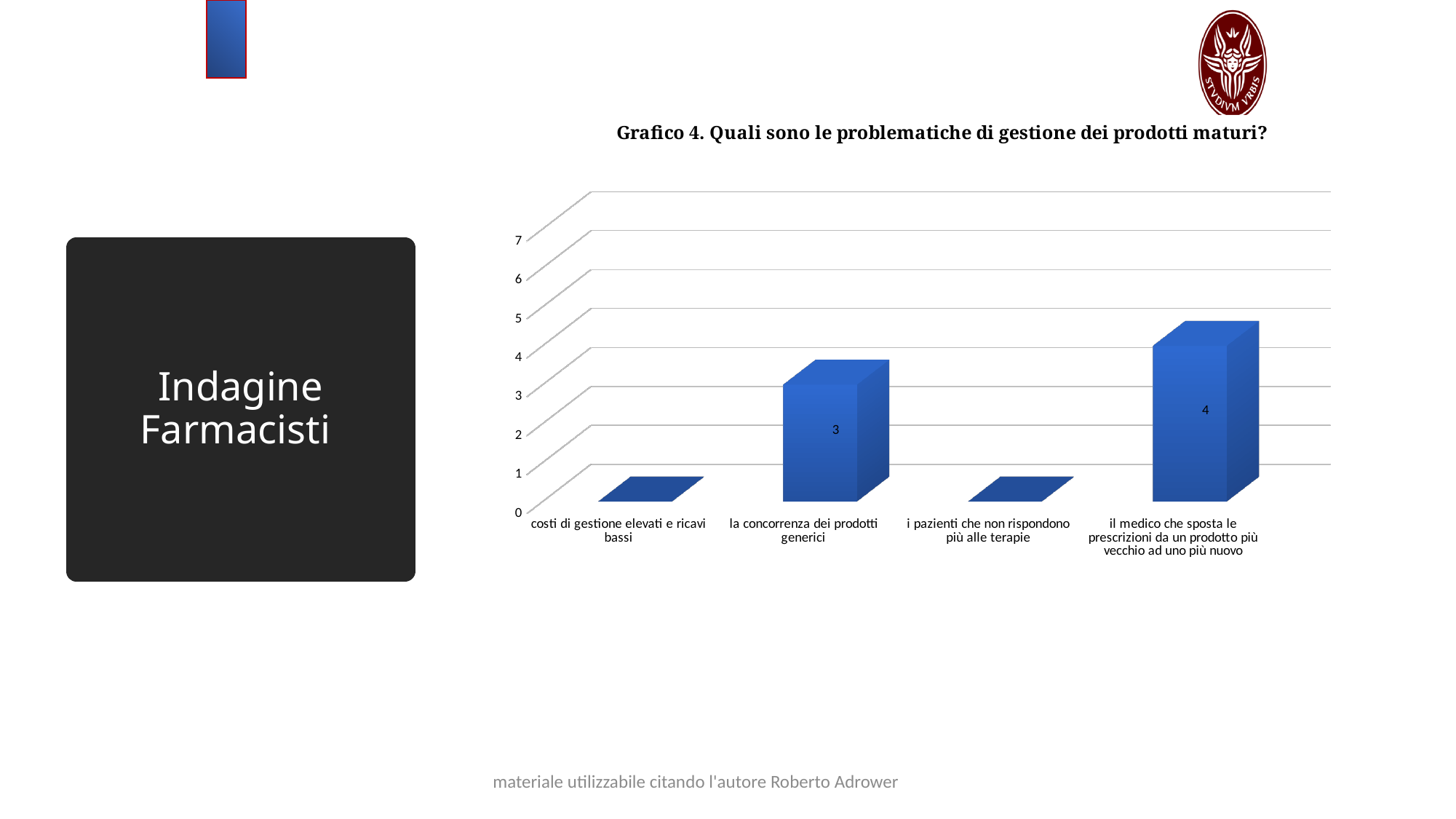
What is the value for 'la concorrenza dei prodotti generici'? 3 Is the value for 'costi di gestione elevati e ricavi bassi' greater or less than 1? less Is the value for 'il medico che sposta le prescrizioni da un prodotto più vecchio ad uno più nuovo' greater or less than 2? greater What is the value for 'il medico che sposta le prescrizioni da un prodotto più vecchio ad uno più nuovo'? 4 What is the highest value shown on the vertical axis of the chart? 7 What is the difference between the value for 'il medico che sposta le prescrizioni da un prodotto più vecchio ad uno più nuovo' and the value for 'la concorrenza dei prodotti generici'? 1 Which category has the highest value? il medico che sposta le prescrizioni da un prodotto più vecchio ad uno più nuovo Which is larger: the value for 'la concorrenza dei prodotti generici' or the value for 'il medico che sposta le prescrizioni da un prodotto più vecchio ad uno più nuovo'? il medico che sposta le prescrizioni da un prodotto più vecchio ad uno più nuovo Is the value for 'i pazienti che non rispondono più alle terapie' greater or less than 1? less How many categories are shown on the x axis of the chart? 4 What is the title of the chart? Grafico 4. Quali sono le problematiche di gestione dei prodotti maturi? What kind of chart is shown on the slide? bar chart